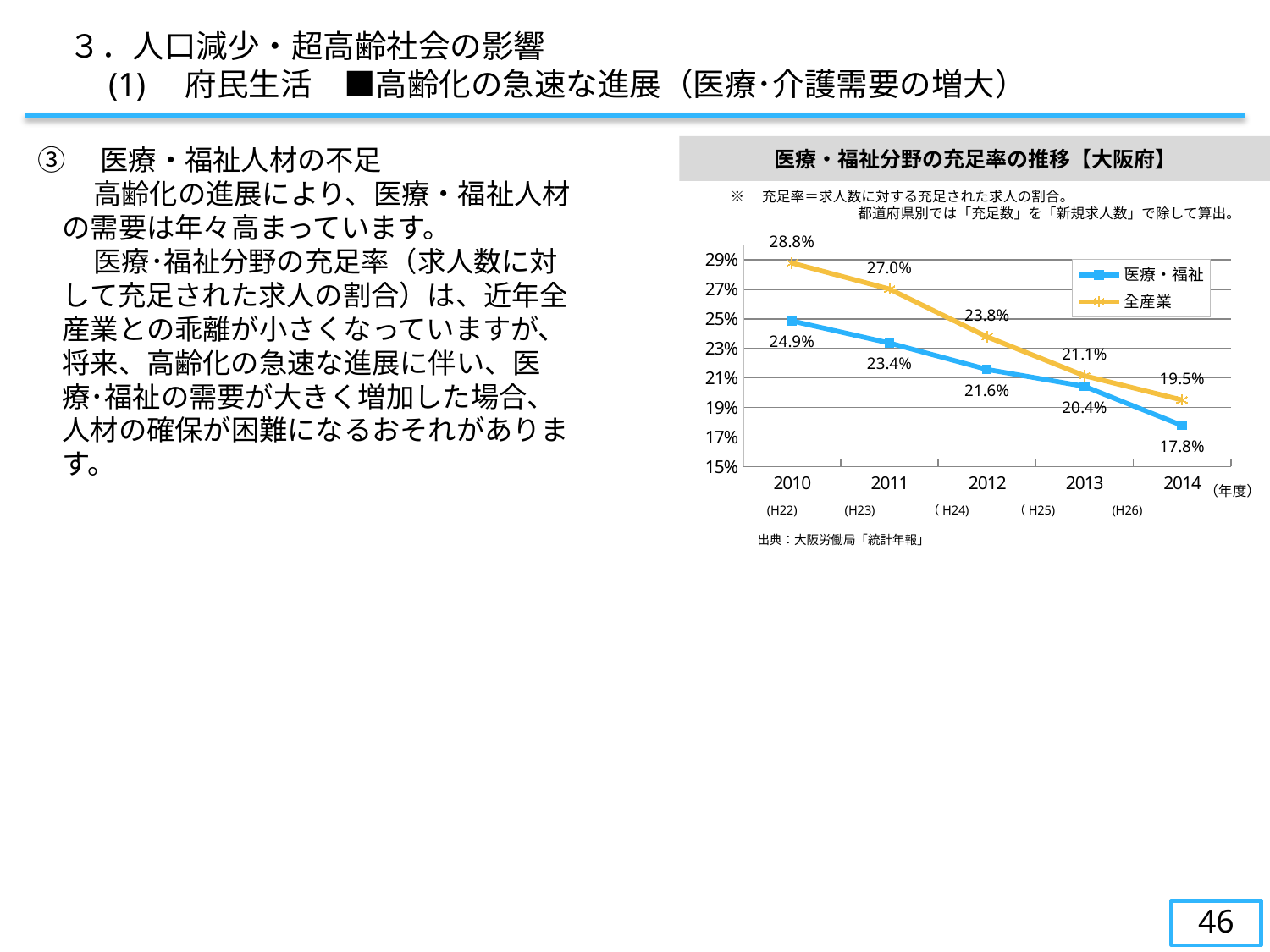
In which year is the 医療・福祉 value lowest? 2014 What is the difference between 全産業 and 医療・福祉 in 2010? 3.9% What is the difference between 全産業 and 医療・福祉 in 2014? 1.7% What is the value for 全産業 in 2014? 19.5% Which series has the larger value in 2011, 医療・福祉 or 全産業? 全産業 What is the value for 全産業 in 2012? 23.8% Do the 医療・福祉 values rise or fall from 2010 to 2014? fall How many series does the legend list? 2 In which year is the 全産業 value highest? 2010 What type of chart is shown on the slide? line chart What is the value for 医療・福祉 in 2010? 24.9% What is the value for 医療・福祉 in 2013? 20.4%